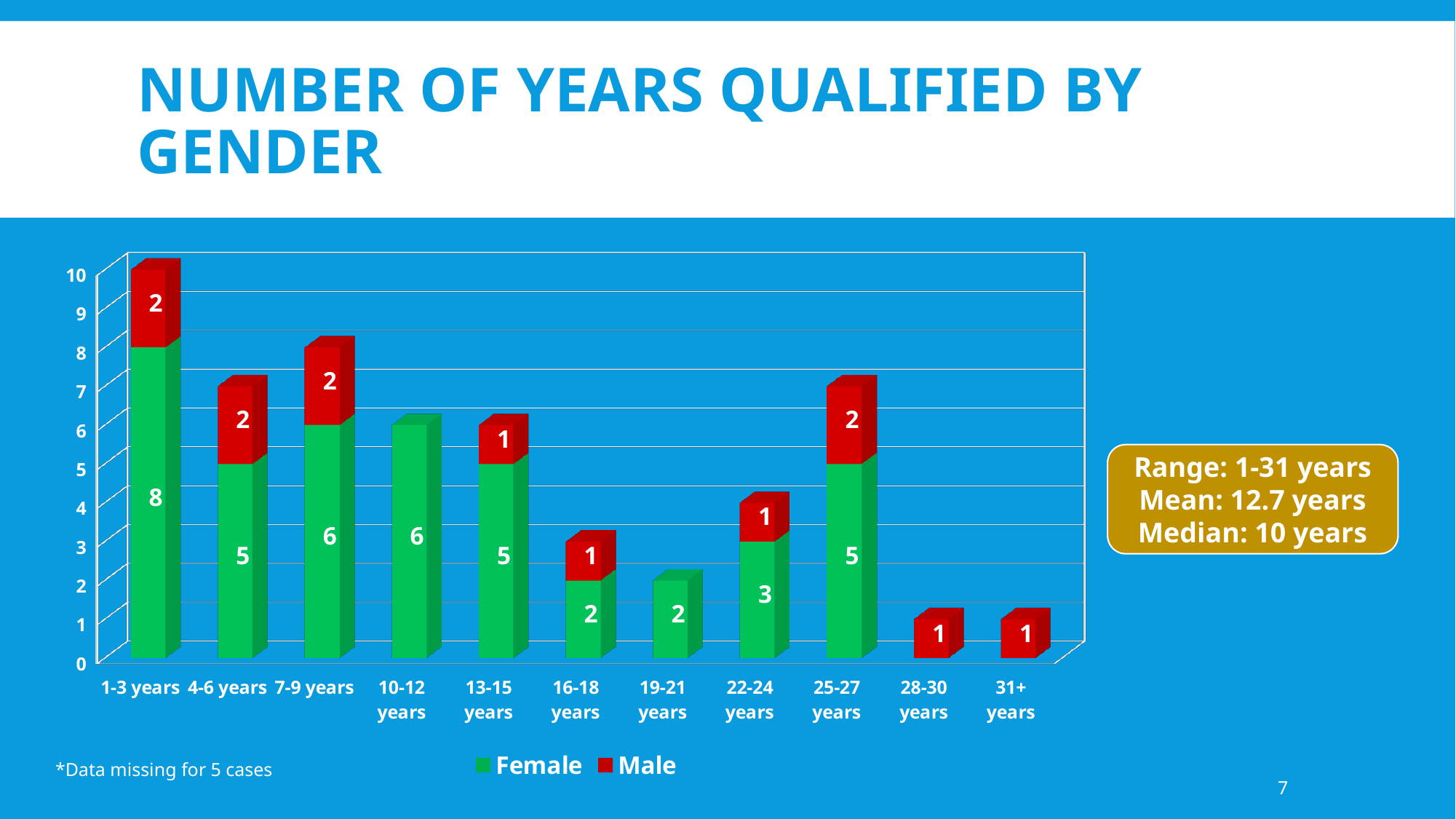
How many categories are shown on the x axis? 11 What is the title of the chart on the slide? Number of Years Qualified by Gender What is the Female value for the 1-3 years category? 8 What is the difference between the Female values for 1-3 years and 13-15 years? 3 What is the Female value for the 22-24 years category? 3 Which is larger, the Female value for 10-12 years or the Female value for 16-18 years? 10-12 years What kind of chart is shown on the slide? Stacked bar chart What is the Male value for the 25-27 years category? 2 What is the total of the stacked bar for the 7-9 years category? 8 What is the total of the stacked bar for the 4-6 years category? 7 How many series does the legend list? 2 Which category has the highest Female value? 1-3 years